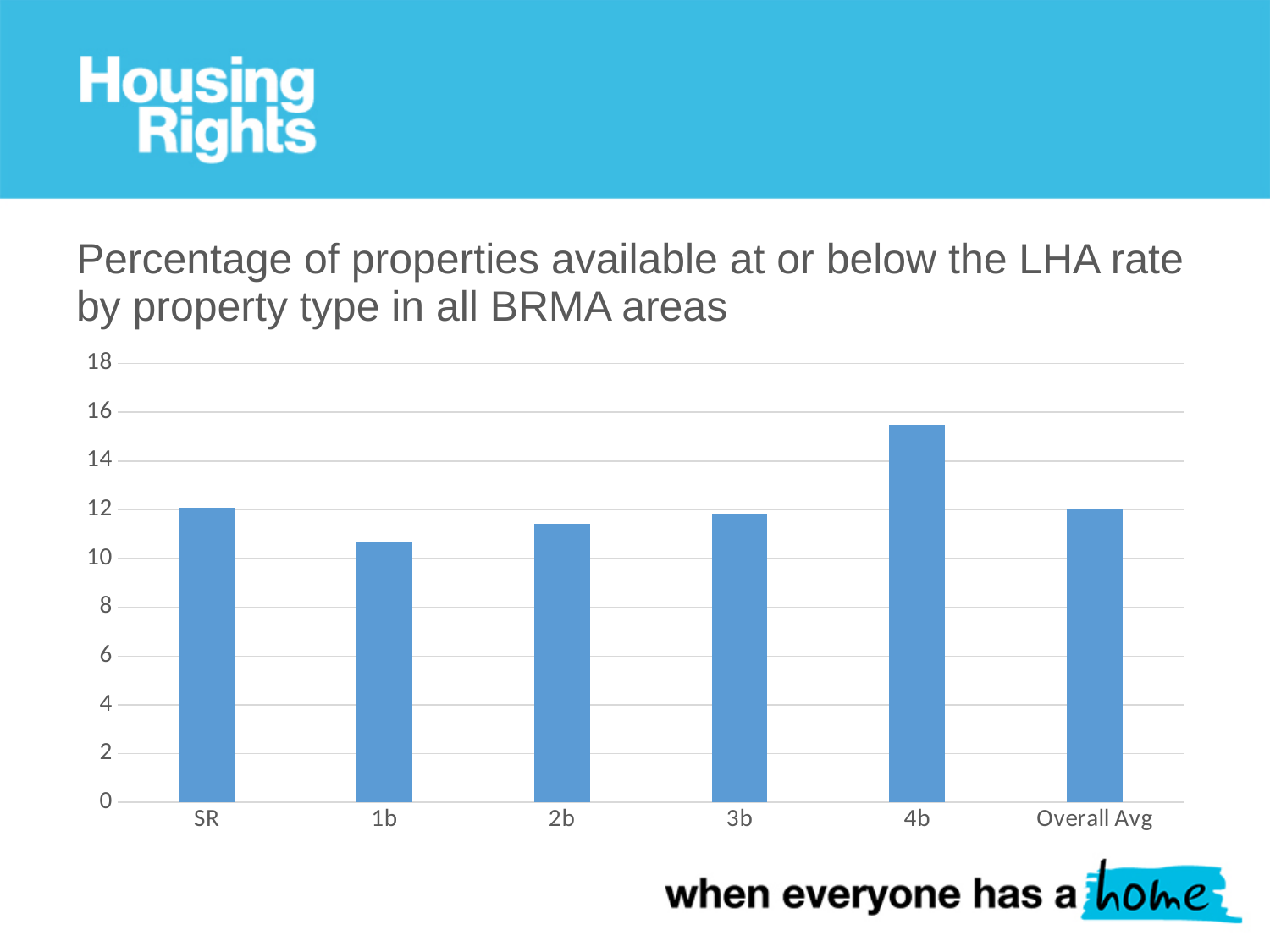
Which is larger, the value for SR or the value for 1b? SR Is the value for Overall Avg greater or less than 14? less What kind of chart is shown on the slide? bar chart Which property type has the lowest percentage of properties available at or below the LHA rate? 1b How many property type categories are plotted on the x axis? 6 Is the value for 4b greater or less than 14? greater What is the title of the chart? Percentage of properties available at or below the LHA rate by property type in all BRMA areas Is the value for 2b greater or less than 12? less Which is larger, the value for 4b or the value for 1b? 4b Which property type has the highest percentage of properties available at or below the LHA rate? 4b